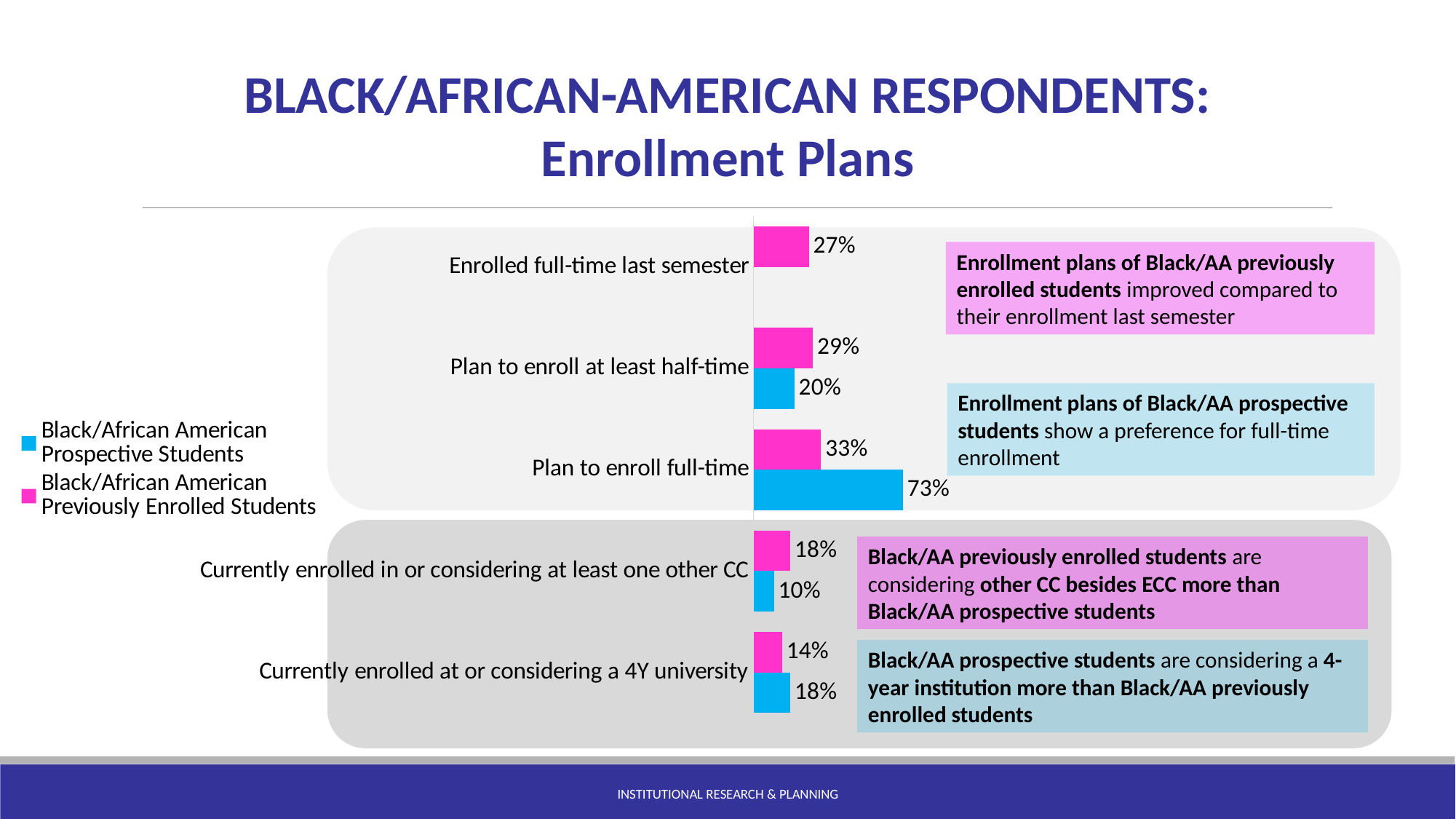
How many series does the legend list? 2 How many categories are shown on the chart? 5 Which category has the lowest value for Black/African American Previously Enrolled Students? Currently enrolled at or considering a 4Y university Which category has the highest value for Black/African American Prospective Students? Plan to enroll full-time What percentage of Black/African American Previously Enrolled Students were enrolled full-time last semester? 27% What type of chart is shown on the slide? Bar chart What is the difference between Prospective Students and Previously Enrolled Students for 'Plan to enroll full-time'? 40% For 'Currently enrolled in or considering at least one other CC', which group has the larger value: Prospective Students or Previously Enrolled Students? Previously Enrolled Students What percentage of Black/African American Prospective Students plan to enroll full-time? 73% What percentage of Black/African American Prospective Students are currently enrolled in or considering at least one other CC? 10% What percentage of Black/African American Previously Enrolled Students plan to enroll at least half-time? 29% For 'Currently enrolled at or considering a 4Y university', which group has the larger value: Prospective Students or Previously Enrolled Students? Prospective Students